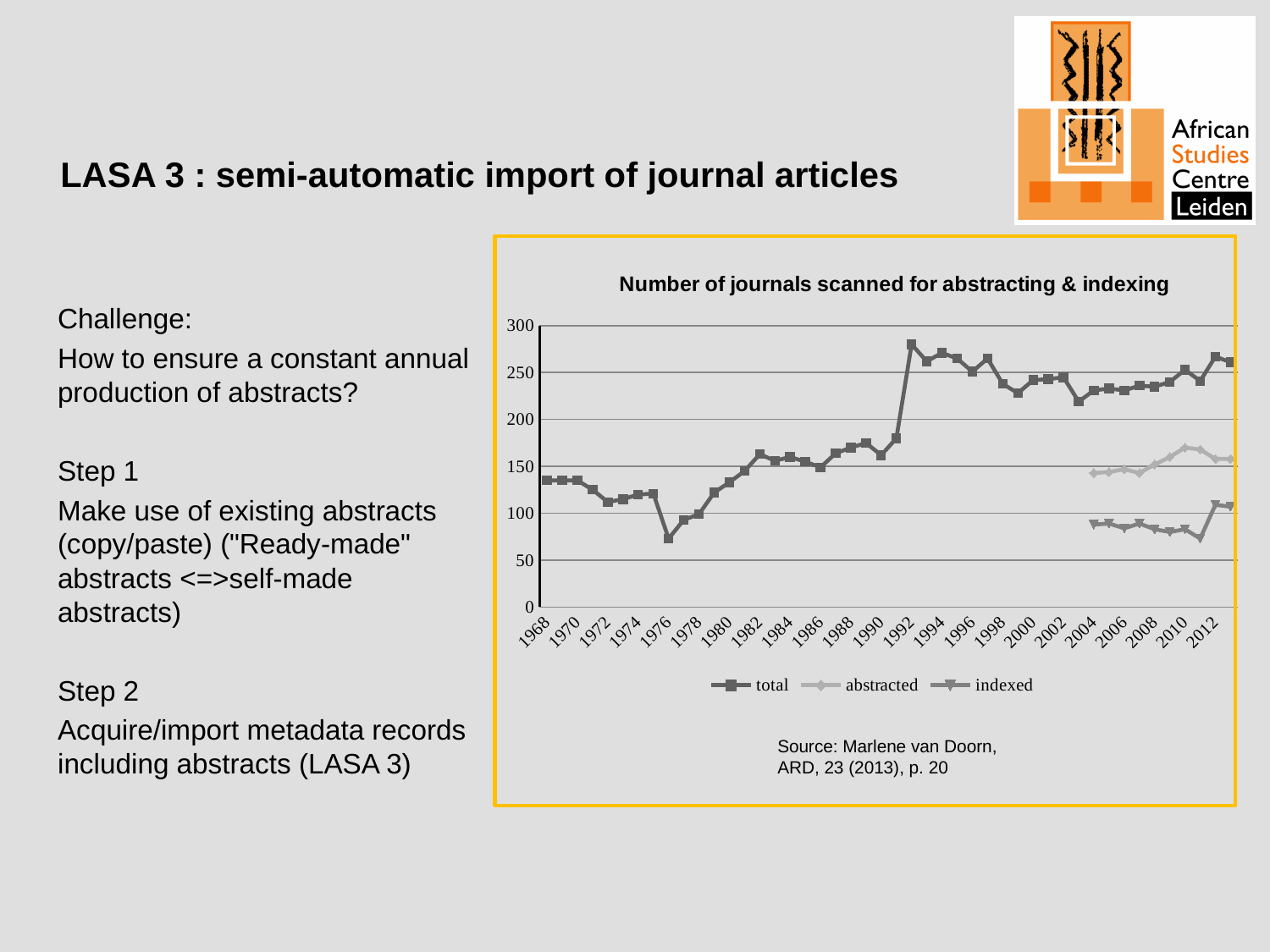
How many series does the chart legend list? 3 In which year does the total series reach its highest value? 1992 Is the value of the indexed series in 2004 greater or less than 100? less Which series has the higher value in 2008, abstracted or indexed? abstracted What is the title of the chart? Number of journals scanned for abstracting & indexing Which series are listed in the chart legend? total, abstracted, indexed What kind of chart is shown on the slide? line chart In which year does the total series reach its lowest value? 1976 Is the value of the abstracted series in 2010 greater or less than 150? greater Is the value of the total series in 1992 greater or less than 250? greater Does the total series rise or fall between 1990 and 1992? rise